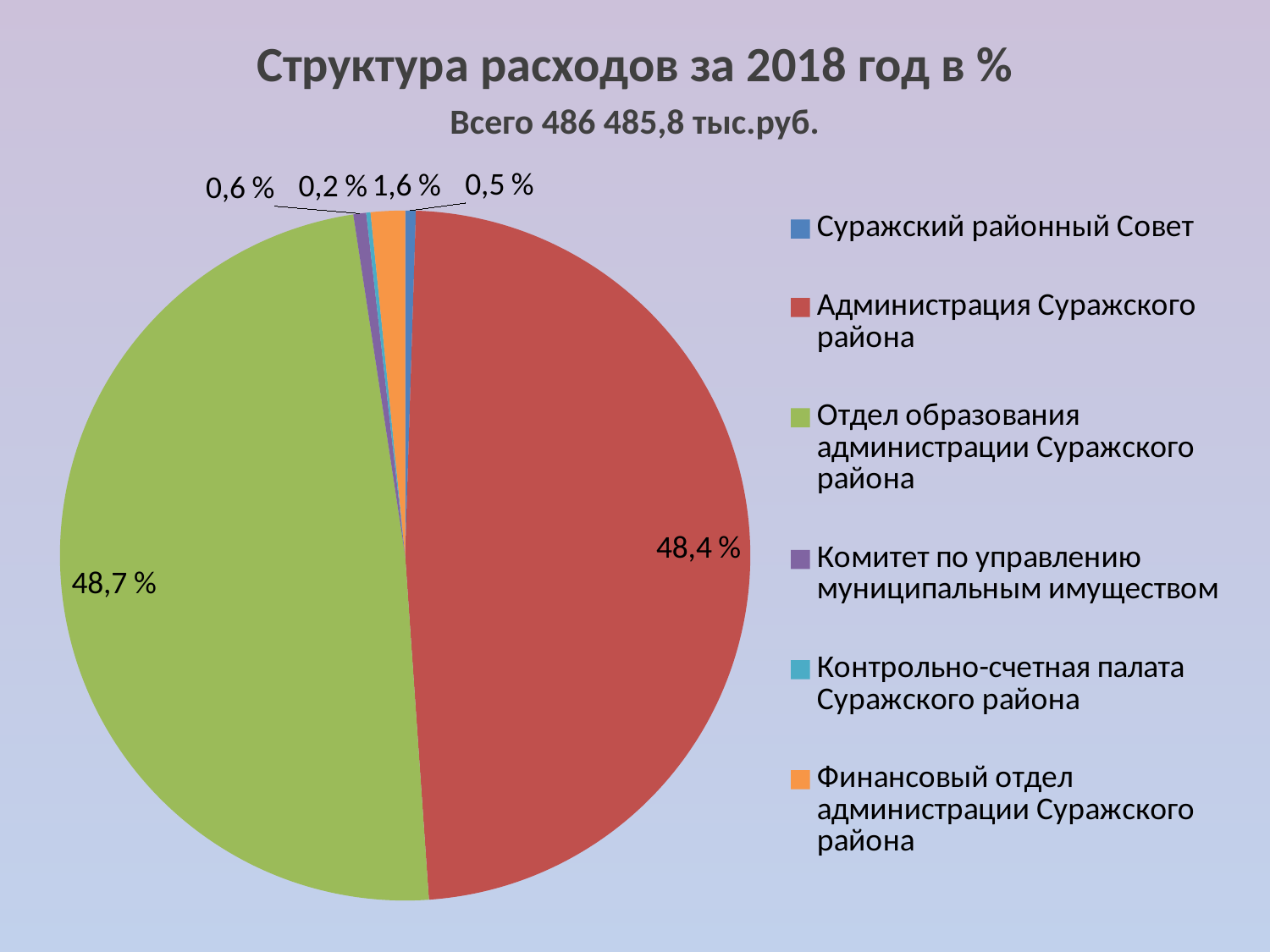
Which has a larger share: Финансовый отдел администрации Суражского района or Суражский районный Совет? Финансовый отдел администрации Суражского района What share of expenditures does Комитет по управлению муниципальным имуществом account for? 0,6 % Which category has the largest share of expenditures? Отдел образования администрации Суражского района What share of expenditures does Финансовый отдел администрации Суражского района account for? 1,6 % What share of expenditures does Контрольно-счетная палата Суражского района account for? 0,2 % Which category has the smallest share of expenditures? Контрольно-счетная палата Суражского района What share of expenditures does Администрация Суражского района account for? 48,4 % What is the difference between the shares of Отдел образования администрации Суражского района and Администрация Суражского района? 0,3 % How many categories are shown in the pie chart? 6 What type of chart is shown on the slide? Pie chart What share of expenditures does Отдел образования администрации Суражского района account for? 48,7 % What share of expenditures does Суражский районный Совет account for? 0,5 %